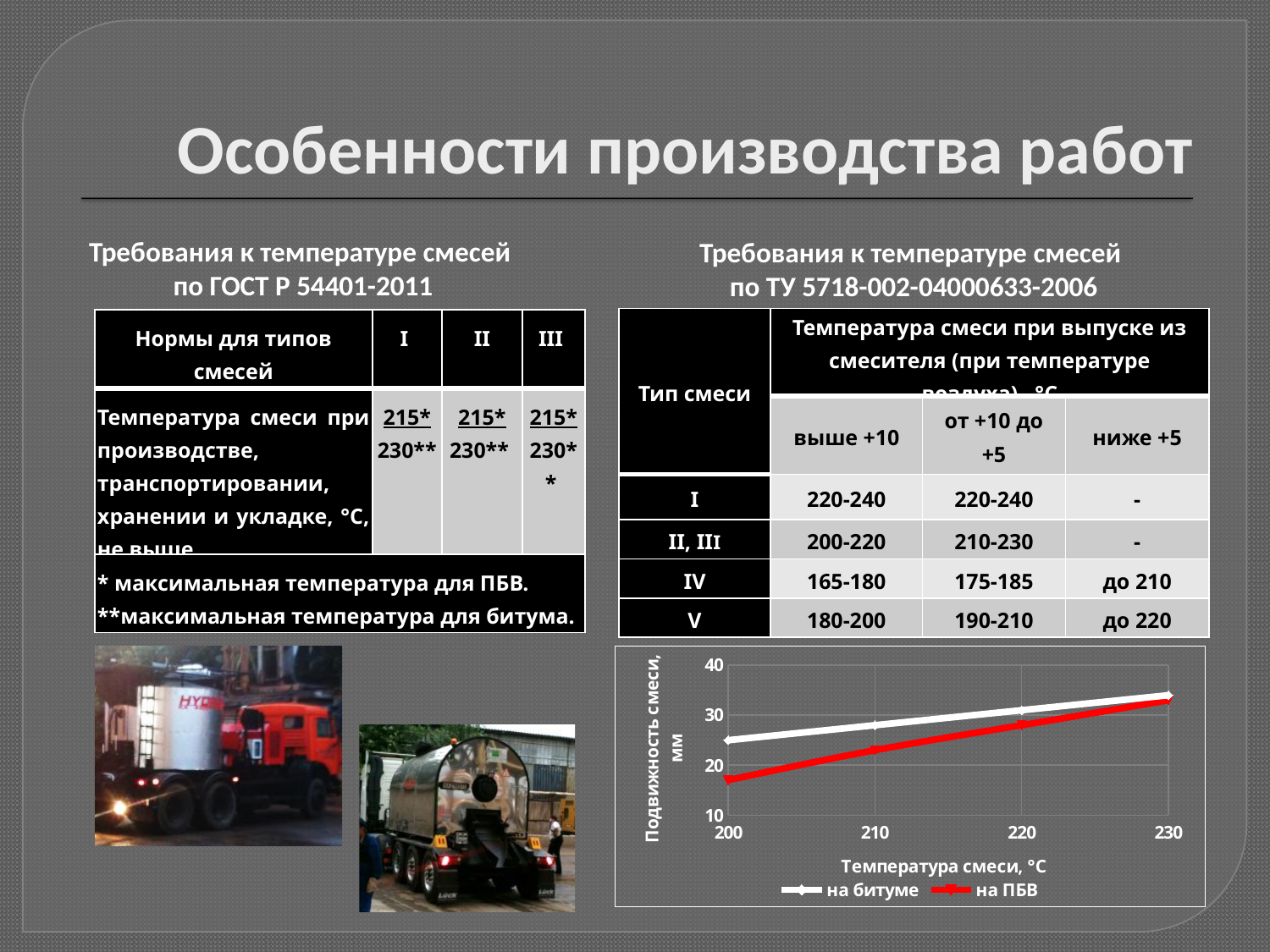
Do the values for 'на ПБВ' rise or fall as the mix temperature increases from 200 to 230? rise Is the value for 'на битуме' at 230 °C greater or less than 30? greater How many series does the chart legend list? 2 How many temperature points are plotted for each series on the chart? 4 What are the two series named in the chart legend? на битуме, на ПБВ Do the values for 'на битуме' rise or fall along the x axis? rise What is the title of the x axis of the chart? Температура смеси, °C At 200 °C, which series has the larger value, 'на битуме' or 'на ПБВ'? на битуме Is the value for 'на битуме' at 200 °C greater or less than 20? greater Is the value for 'на ПБВ' at 210 °C greater or less than 20? greater What kind of chart is shown on the slide? line chart